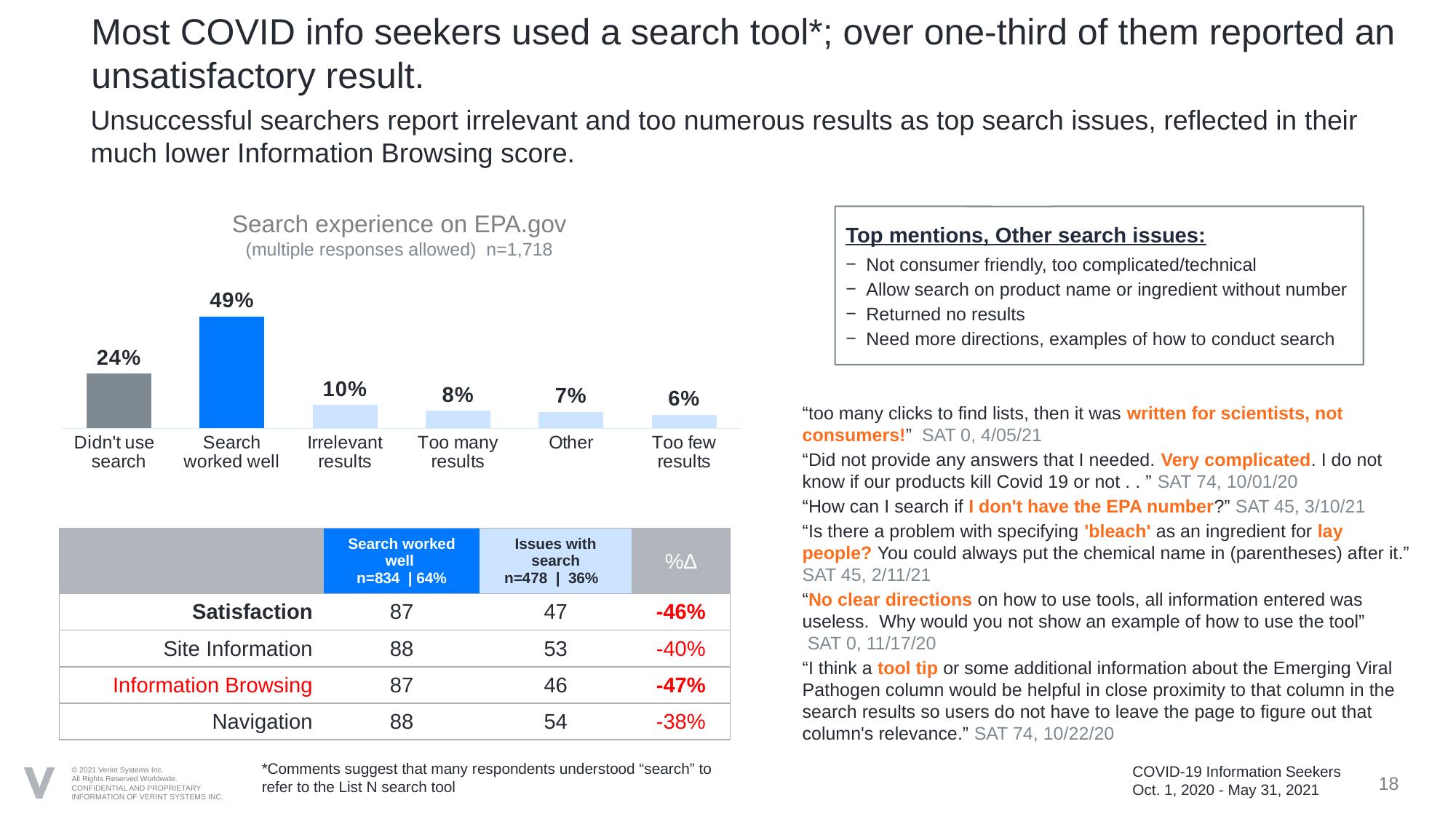
What type of chart is shown on the slide? Bar chart What is the difference between the 'Search worked well' and 'Didn't use search' percentages? 25% What percentage of respondents said search worked well? 49% What percentage of respondents reported irrelevant results? 10% What is the difference between the 'Irrelevant results' and 'Too few results' percentages? 4% Which category has the highest value in the chart? Search worked well How many categories are shown in the chart? 6 What is the sample size (n) shown under the chart title? n=1,718 What is the title of the chart? Search experience on EPA.gov What percentage of respondents didn't use search? 24% Which is larger, 'Too many results' or 'Other'? Too many results Which category has the lowest value in the chart? Too few results